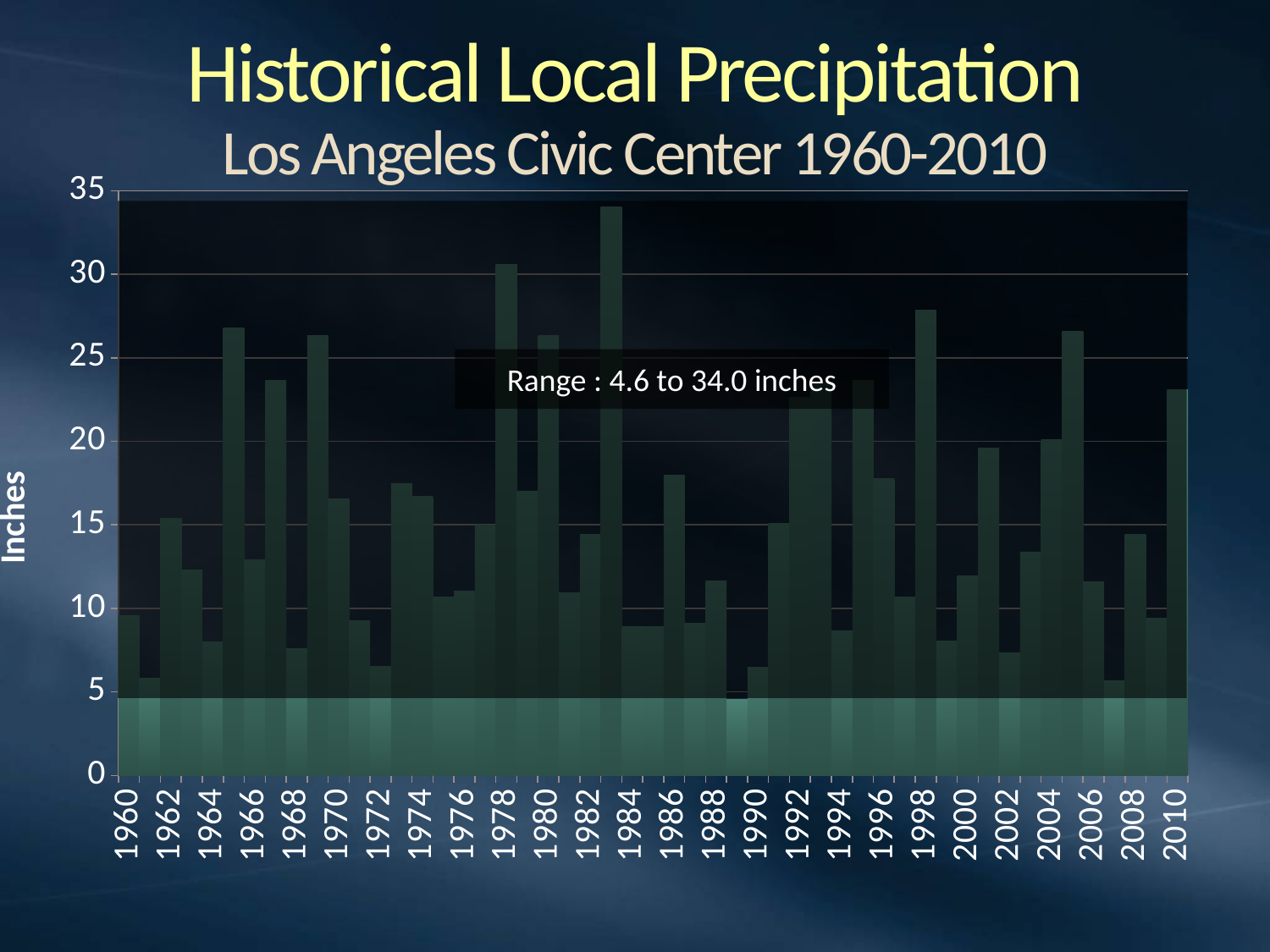
What is the highest annual precipitation value shown, according to the range annotation? 34.0 inches How many years of data are plotted in the chart? 51 What is the lowest annual precipitation value shown, according to the range annotation? 4.6 inches What kind of chart is shown on the slide? bar chart Is the precipitation value for 1972 greater or less than 10 inches? less What is the difference between the highest and lowest precipitation values stated in the range annotation? 29.4 inches Which year has the shortest bar in the chart? 1989 What range of values does the annotation on the chart state? 4.6 to 34.0 inches Is the precipitation value for 1998 greater or less than 25 inches? greater What is the label on the vertical axis of the chart? Inches Which year has the tallest bar in the chart? 1983 Which year had more precipitation, 1983 or 1978? 1983